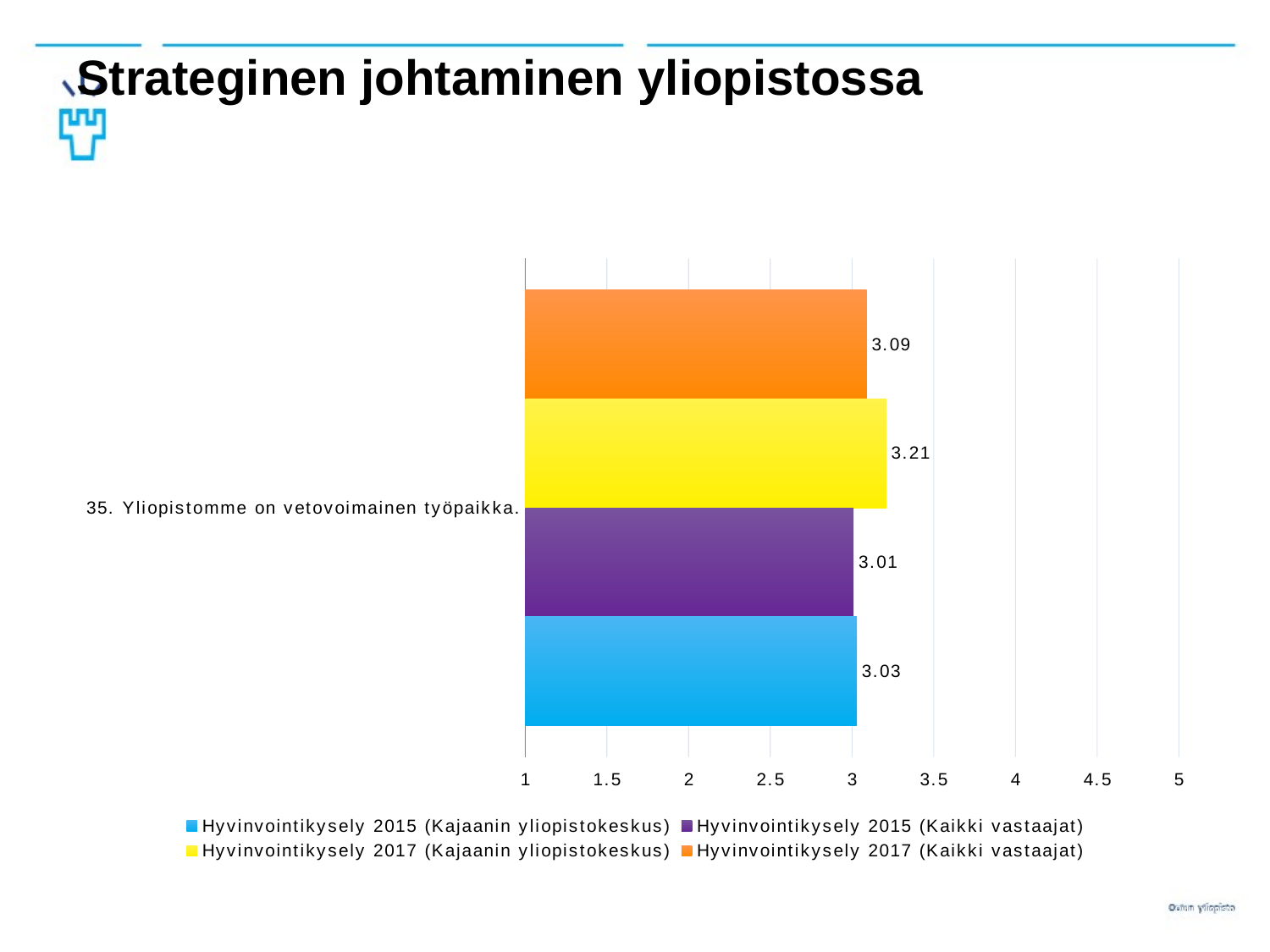
What is the category label shown on the chart? 35. Yliopistomme on vetovoimainen työpaikka. Which is larger: the value for Hyvinvointikysely 2017 (Kaikki vastaajat) or Hyvinvointikysely 2015 (Kaikki vastaajat)? Hyvinvointikysely 2017 (Kaikki vastaajat) What is the value for Hyvinvointikysely 2015 (Kaikki vastaajat)? 3.01 Which series has the highest value? Hyvinvointikysely 2017 (Kajaanin yliopistokeskus) What is the value for Hyvinvointikysely 2017 (Kaikki vastaajat)? 3.09 What is the difference between the values for Hyvinvointikysely 2017 (Kajaanin yliopistokeskus) and Hyvinvointikysely 2015 (Kajaanin yliopistokeskus)? 0.18 What is the value for Hyvinvointikysely 2015 (Kajaanin yliopistokeskus)? 3.03 Which series has the lowest value? Hyvinvointikysely 2015 (Kaikki vastaajat) What is the value for Hyvinvointikysely 2017 (Kajaanin yliopistokeskus)? 3.21 What kind of chart is shown on the slide? bar chart How many categories are shown on the chart? 1 How many series does the legend list? 4